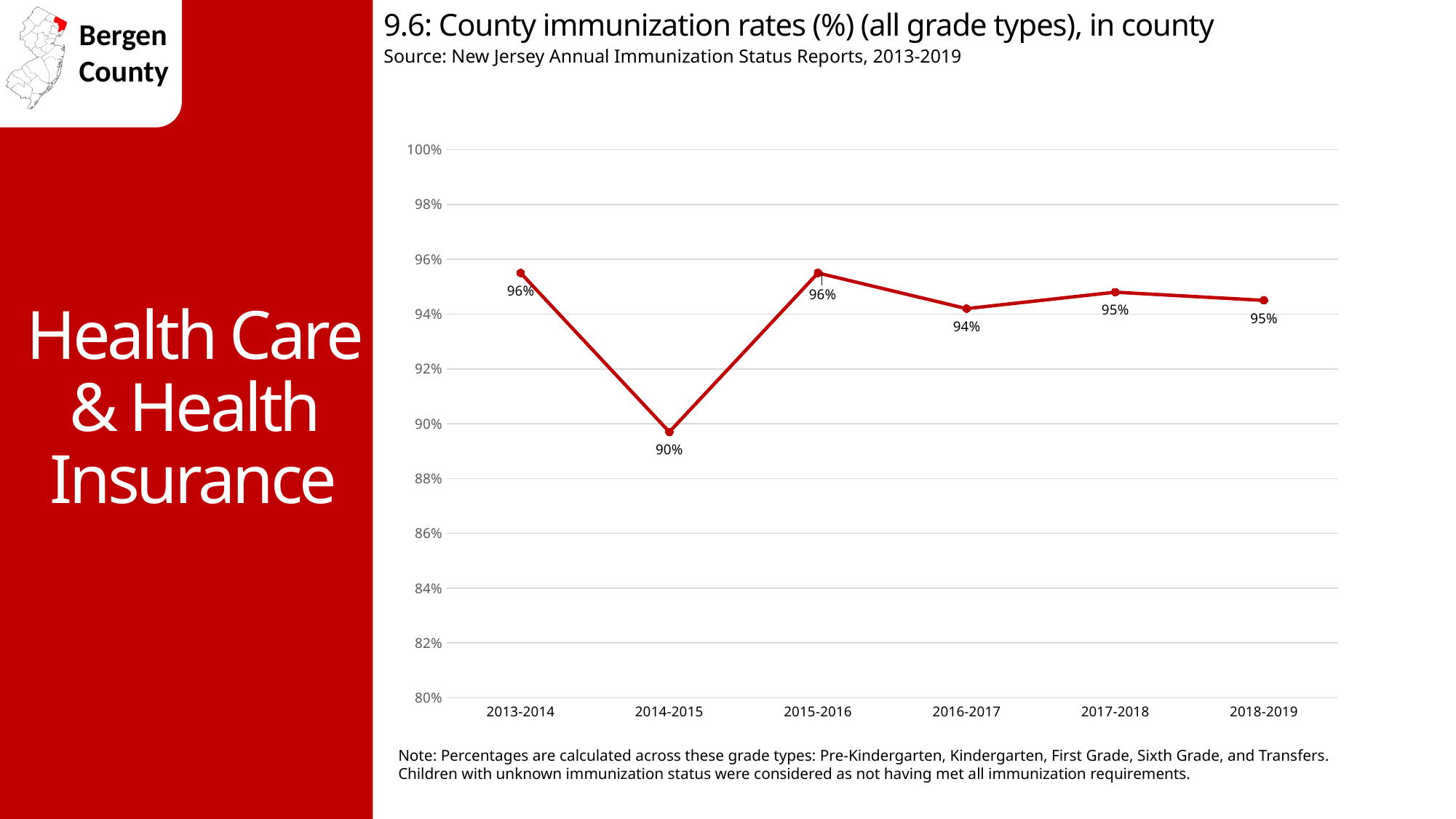
What is the county immunization rate for 2013-2014? 96% Which school year has the lowest immunization rate? 2014-2015 What is the county immunization rate for 2016-2017? 94% Which is larger, the immunization rate for 2016-2017 or for 2014-2015? 2016-2017 Does the immunization rate rise or fall from 2013-2014 to 2014-2015? Fall Is the value for 2014-2015 greater or less than 92%? less Is the value for 2016-2017 greater or less than 92%? greater What is the difference in percentage points between the 2013-2014 rate and the 2014-2015 rate? 6 percentage points What is the county immunization rate for 2018-2019? 95% What is the county immunization rate for 2014-2015? 90% How many school years are plotted on the chart? 6 What kind of chart is shown on the slide? Line chart